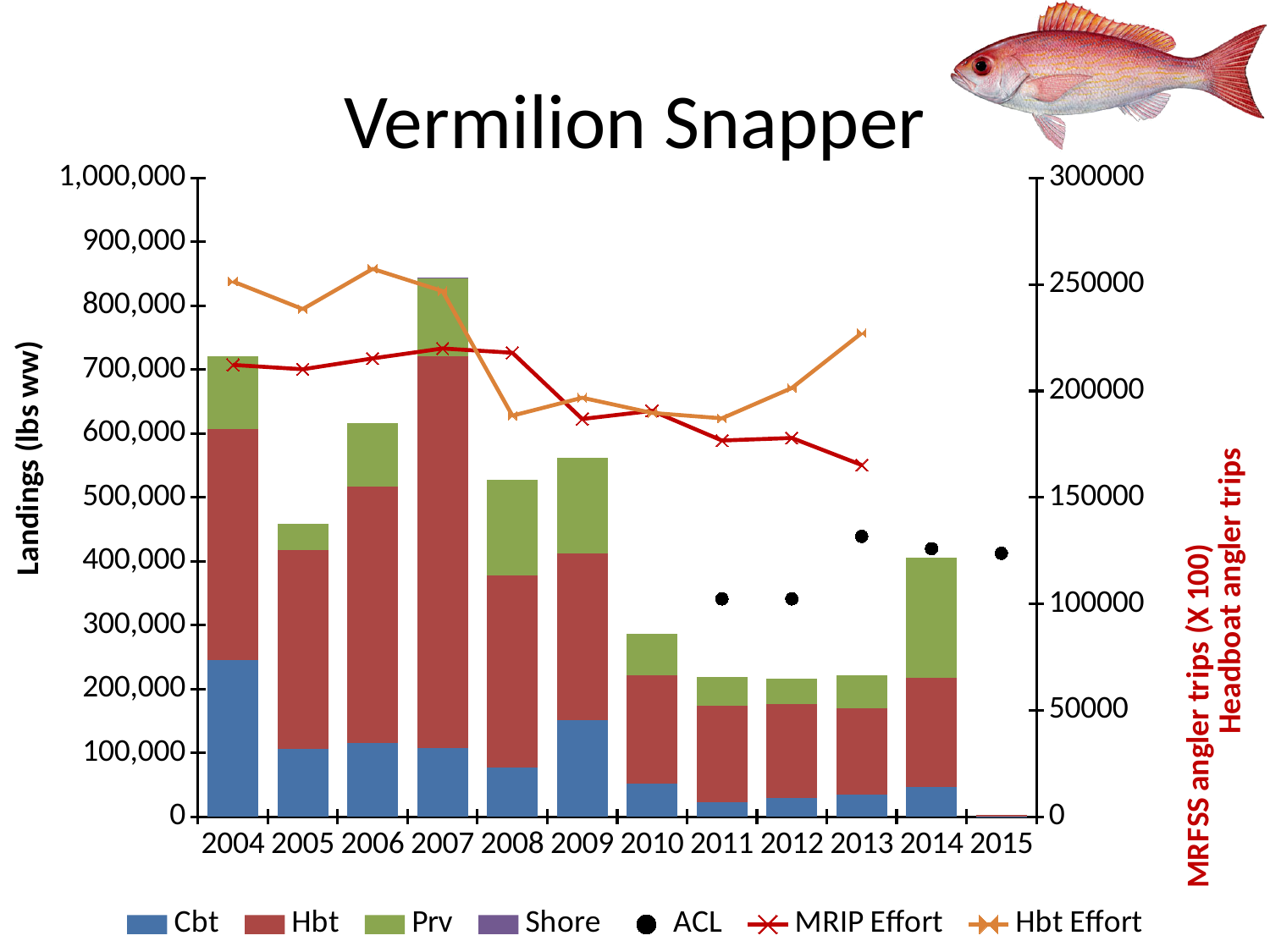
What is the title of the chart? Vermilion Snapper Which year has the highest total landings? 2007 Is the Cbt value for 2004 greater or less than 200,000? greater Which year has higher total landings, 2004 or 2009? 2004 Is the total landings value for 2005 greater or less than 500,000? less Which year has the lowest total landings? 2015 What kind of chart is used to show the landings? Stacked bar chart Which year has the higher ACL, 2011 or 2013? 2013 Does the MRIP Effort line rise or fall from 2007 to 2013? fall Is the total landings value for 2007 greater or less than 800,000? greater How many series does the legend list? 7 How many years are shown on the x axis? 12